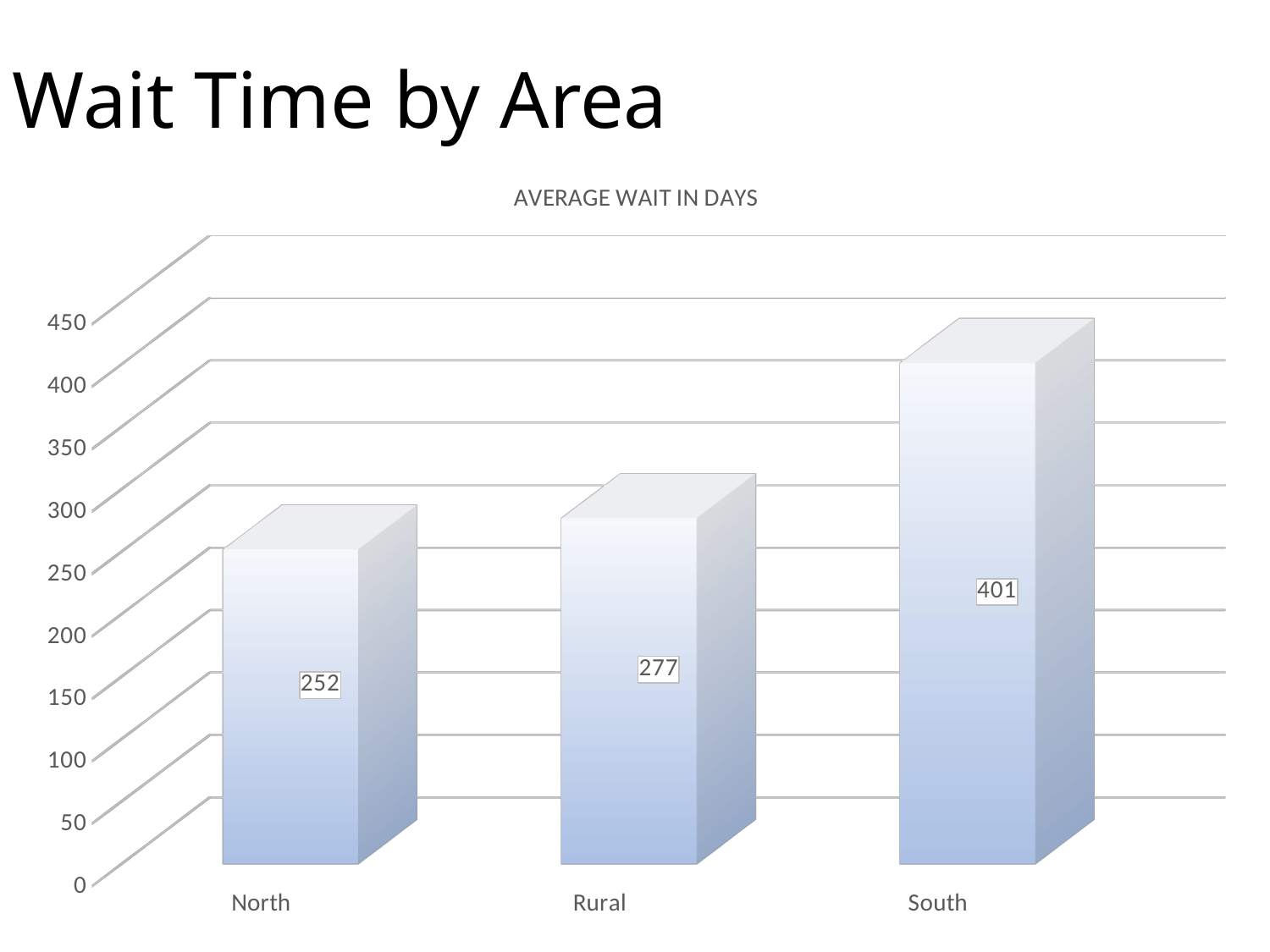
What is the average wait in days for Rural? 277 What is the average wait in days for South? 401 What is the difference in average wait days between South and North? 149 Which area has the lowest average wait? North How many areas are shown in the chart? 3 What kind of chart is shown on the slide? Bar chart What is the difference in average wait days between Rural and North? 25 Is the value for South greater or less than 350? greater Which area has the highest average wait? South Which has a longer average wait, Rural or South? South What is the average wait in days for North? 252 What is the title of the chart? AVERAGE WAIT IN DAYS